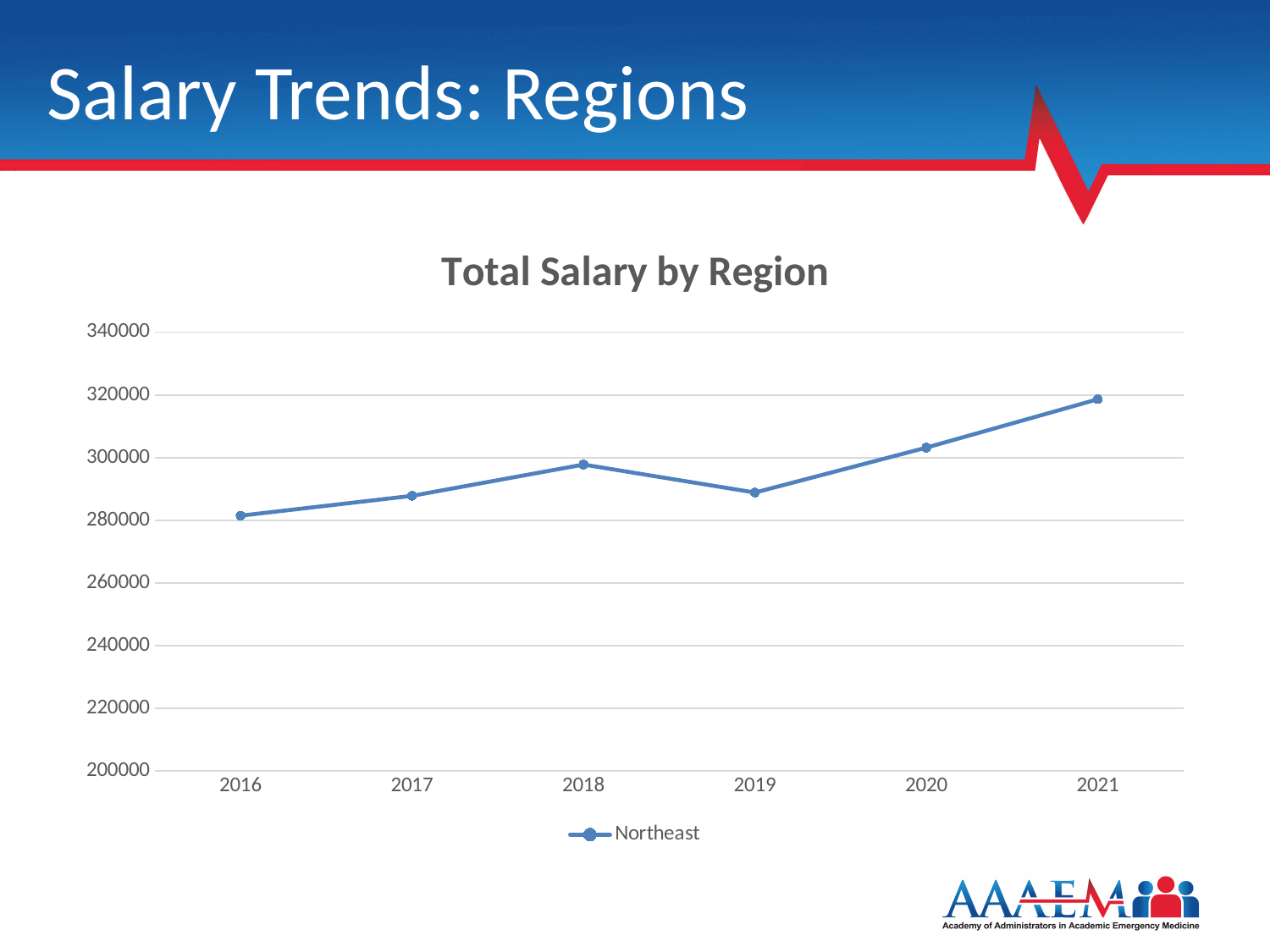
What kind of chart is shown on the slide? line chart Is the value for 2019 greater or less than 300000? less Is the value for 2017 greater or less than 280000? greater Which year has the larger value, 2018 or 2019? 2018 What is the title of the chart? Total Salary by Region Which region is shown in the legend? Northeast How many series does the legend list? 1 Does the Northeast total salary rise or fall between 2016 and 2021 overall? rise How many years are plotted on the x axis? 6 In which year is the Northeast total salary highest? 2021 In which year is the Northeast total salary lowest? 2016 Is the value for 2021 greater or less than 300000? greater